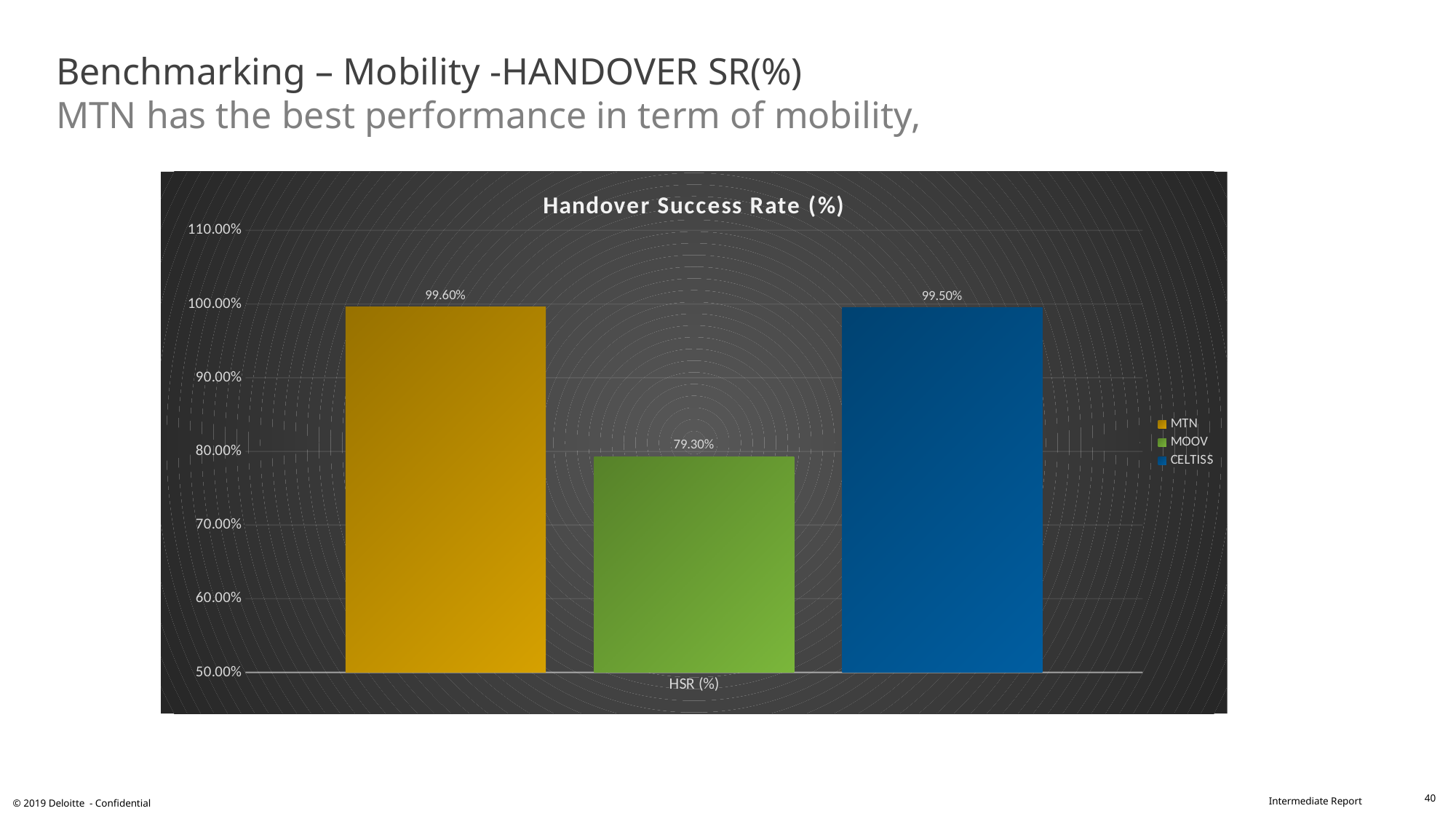
What kind of chart is shown on the slide? bar chart What is the title of the chart? Handover Success Rate (%) What is the Handover Success Rate for MOOV? 79.30% Which operator has the lowest Handover Success Rate? MOOV Which has a higher Handover Success Rate, MOOV or CELTISS? CELTISS What colour is the bar for CELTISS? blue How many series does the legend list? 3 Is the value for MOOV greater or less than 80.00%? less What is the difference between the Handover Success Rate of CELTISS and MOOV? 20.20% What is the difference between the Handover Success Rate of MTN and MOOV? 20.30% What is the Handover Success Rate for CELTISS? 99.50% What is the Handover Success Rate for MTN? 99.60%